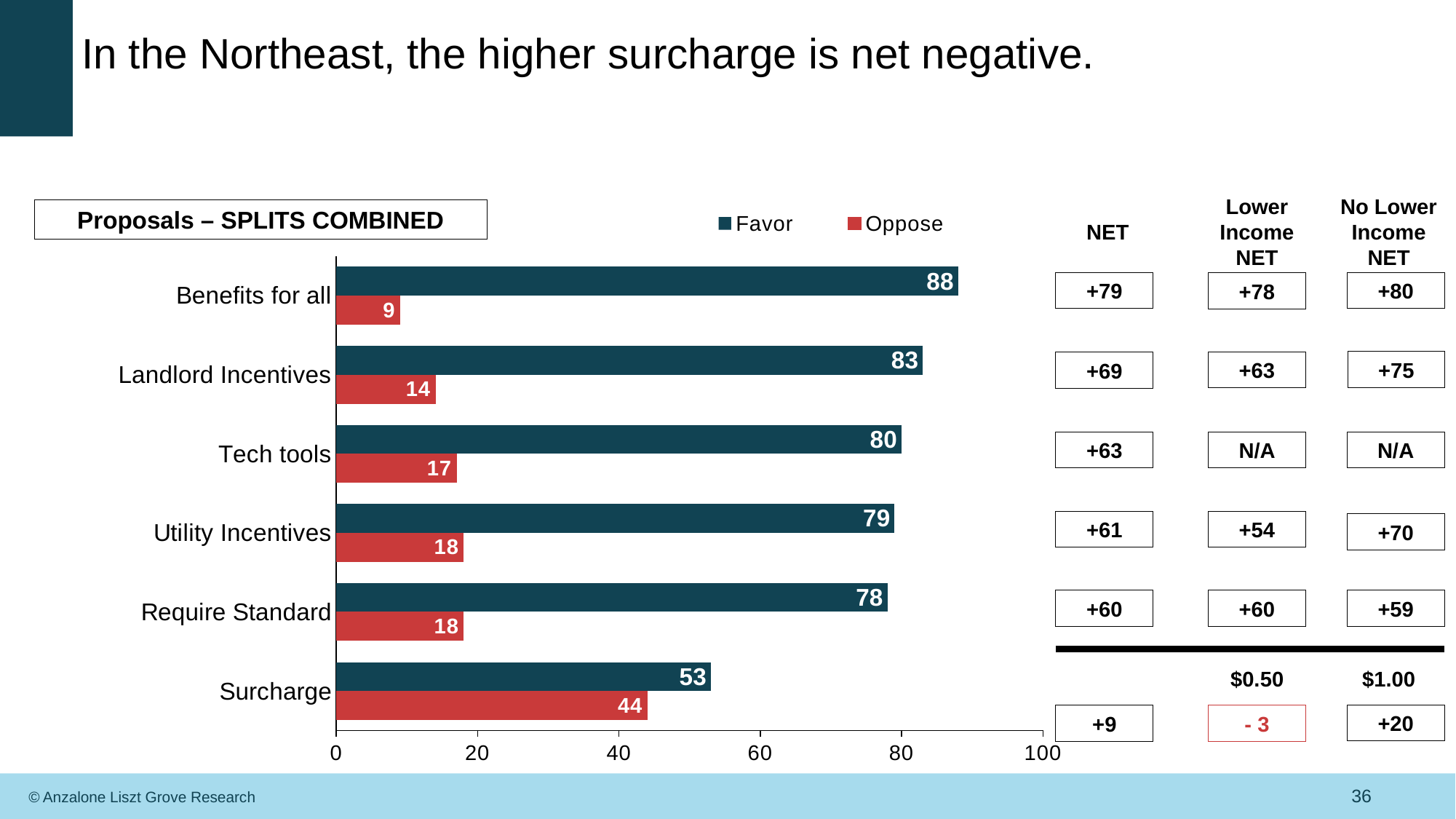
Which proposal has the lowest Favor value? Surcharge Which proposal has the lowest Oppose value? Benefits for all What is the difference between the Favor and Oppose values for Surcharge? 9 Which proposal has the highest Favor value? Benefits for all How many proposals are shown on the chart? 6 What is the Favor value for Benefits for all? 88 Which is larger, the Oppose value for Landlord Incentives or the Oppose value for Tech tools? Tech tools What is the difference between the Favor values for Landlord Incentives and Utility Incentives? 4 What kind of chart is shown on the slide? Bar chart What is the Oppose value for Surcharge? 44 How many series does the legend list? 2 What is the Oppose value for Tech tools? 17